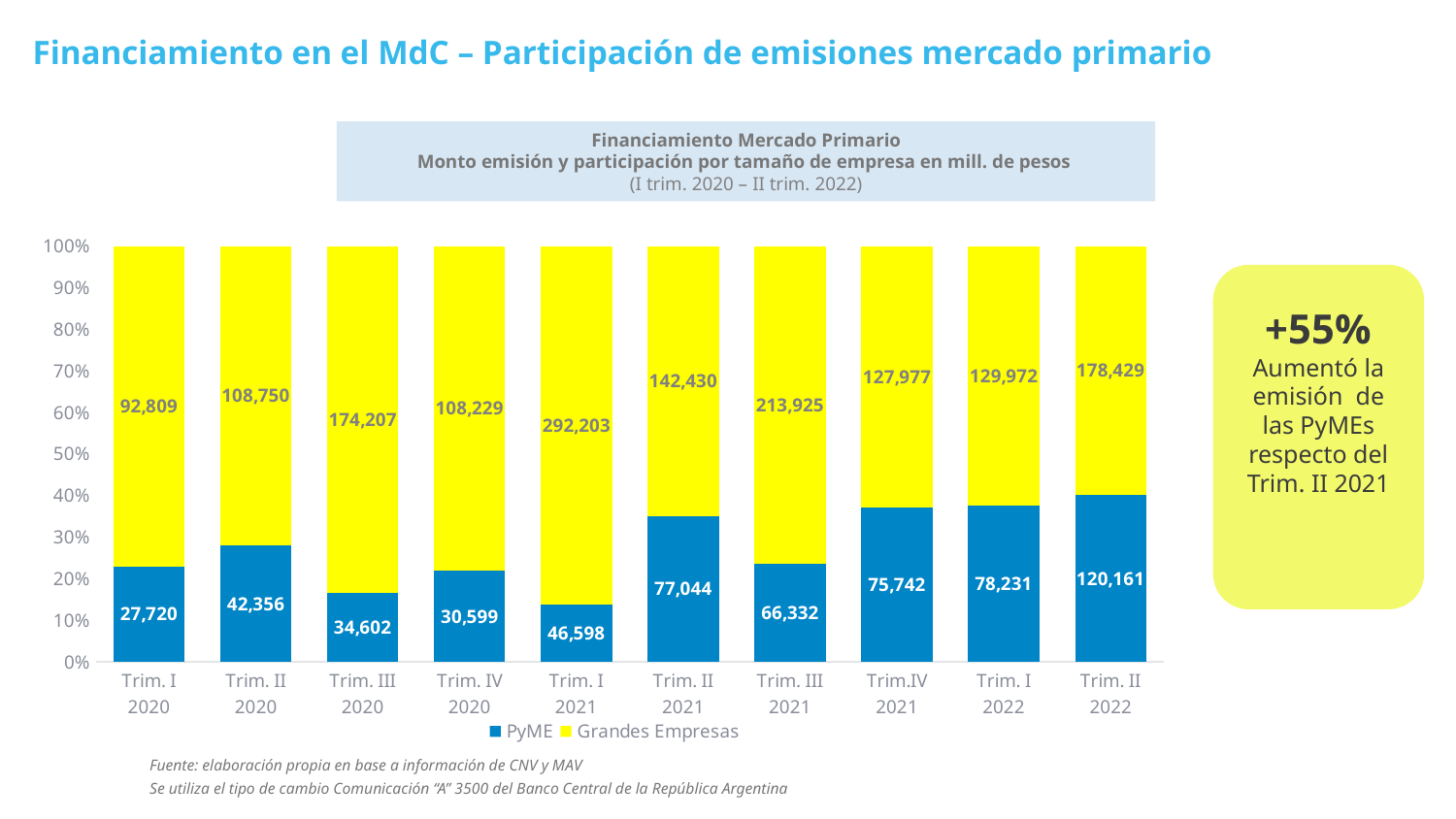
How many quarters are shown on the x axis? 10 Is the PyME share of the bar for Trim. I 2021 greater or less than 20%? less What is the difference between the PyME value for Trim. II 2022 and the PyME value for Trim. II 2021? 43,117 Which quarter has the highest PyME value? Trim. II 2022 What is the total of the PyME and Grandes Empresas values for Trim. I 2020? 120,529 Which is larger: the Grandes Empresas value for Trim. III 2021 or for Trim. II 2022? Trim. III 2021 What kind of chart is shown? Stacked bar chart What is the PyME value for Trim. II 2022? 120,161 How many series does the legend list? 2 What is the Grandes Empresas value for Trim. I 2021? 292,203 Which quarter has the lowest Grandes Empresas value? Trim. I 2020 What is the PyME value for Trim. I 2020? 27,720